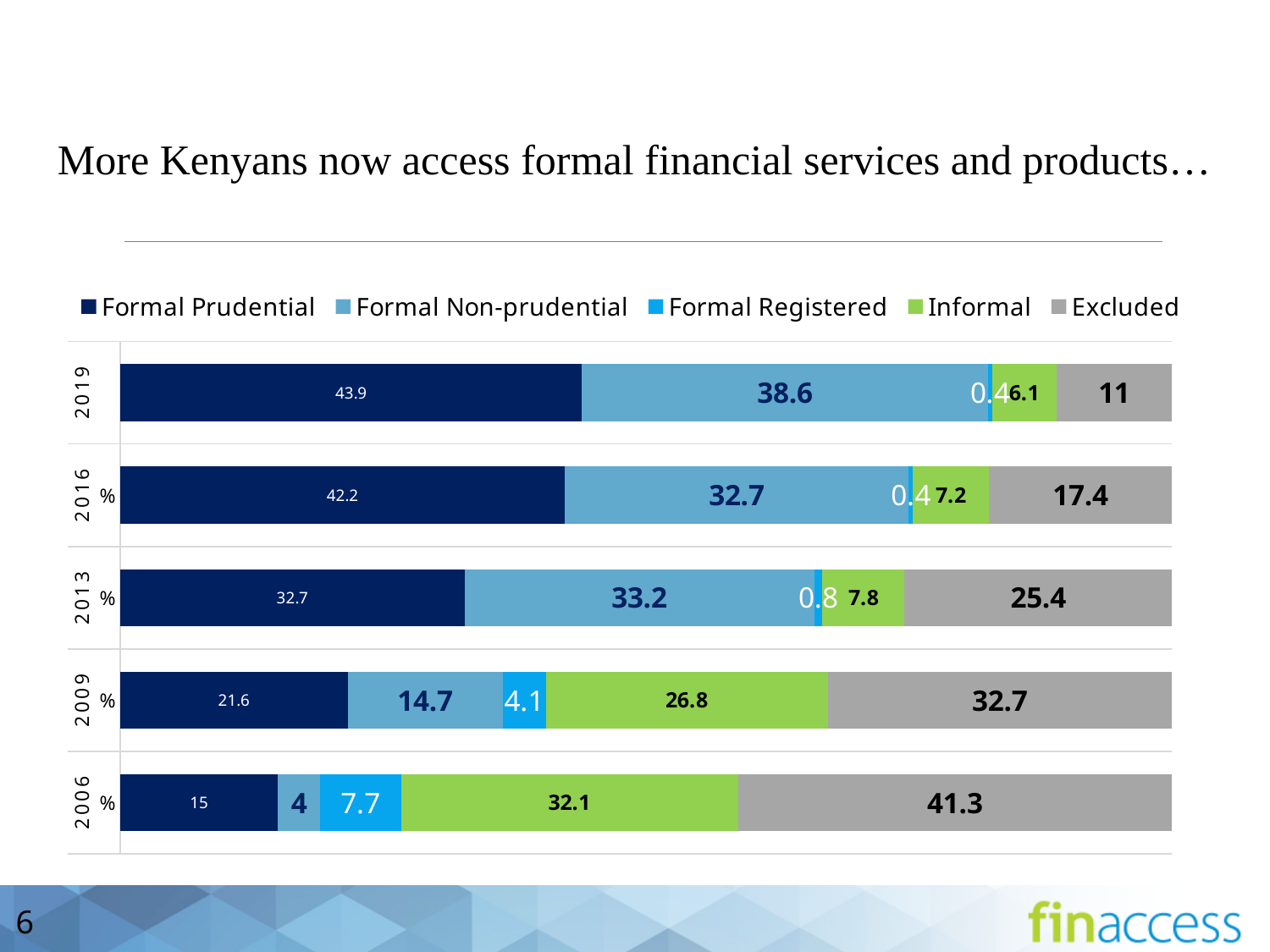
Which year has the highest Excluded value? 2006 Which is larger, the Formal Non-prudential value for 2013 or for 2016? 2013 How many years (bars) are shown in the chart? 5 What is the difference between the Excluded values for 2006 and 2019? 30.3 Which year has the lowest Formal Prudential value? 2006 What is the Informal value for 2009? 26.8 What kind of chart is shown on the slide? Stacked bar chart What is the Formal Prudential value for 2019? 43.9 Does the Formal Prudential value rise or fall from 2006 to 2019? Rise What is the total of the stacked bar for 2019? 100 How many series does the legend list? 5 What is the Excluded value for 2006? 41.3